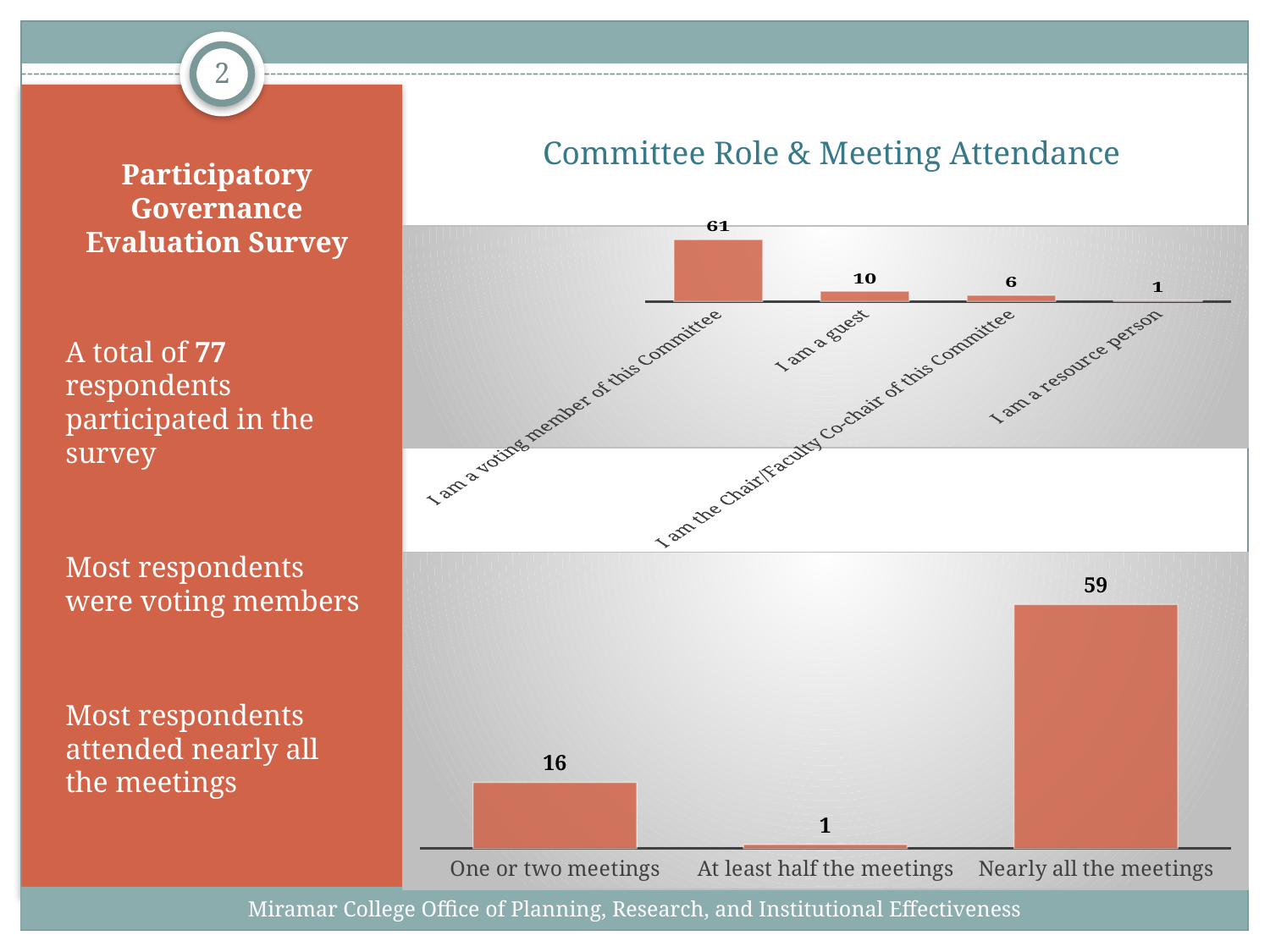
In the bottom chart (meeting attendance), what is the value for 'Nearly all the meetings'? 59 In the top chart (committee role), how many categories are shown? 4 What type of chart is the bottom chart (meeting attendance)? Bar chart In the top chart (committee role), how many respondents said 'I am a voting member of this Committee'? 61 In the top chart (committee role), what is the value for 'I am the Chair/Faculty Co-chair of this Committee'? 6 In the bottom chart (meeting attendance), which is larger: 'One or two meetings' or 'At least half the meetings'? One or two meetings In the bottom chart (meeting attendance), what is the value for 'One or two meetings'? 16 In the top chart (committee role), what is the value for 'I am a guest'? 10 In the bottom chart (meeting attendance), what is the difference between 'Nearly all the meetings' and 'One or two meetings'? 43 In the top chart (committee role), which category has the lowest value? I am a resource person In the top chart (committee role), what is the difference between the values for 'I am a voting member of this Committee' and 'I am a guest'? 51 In the bottom chart (meeting attendance), which category has the highest value? Nearly all the meetings